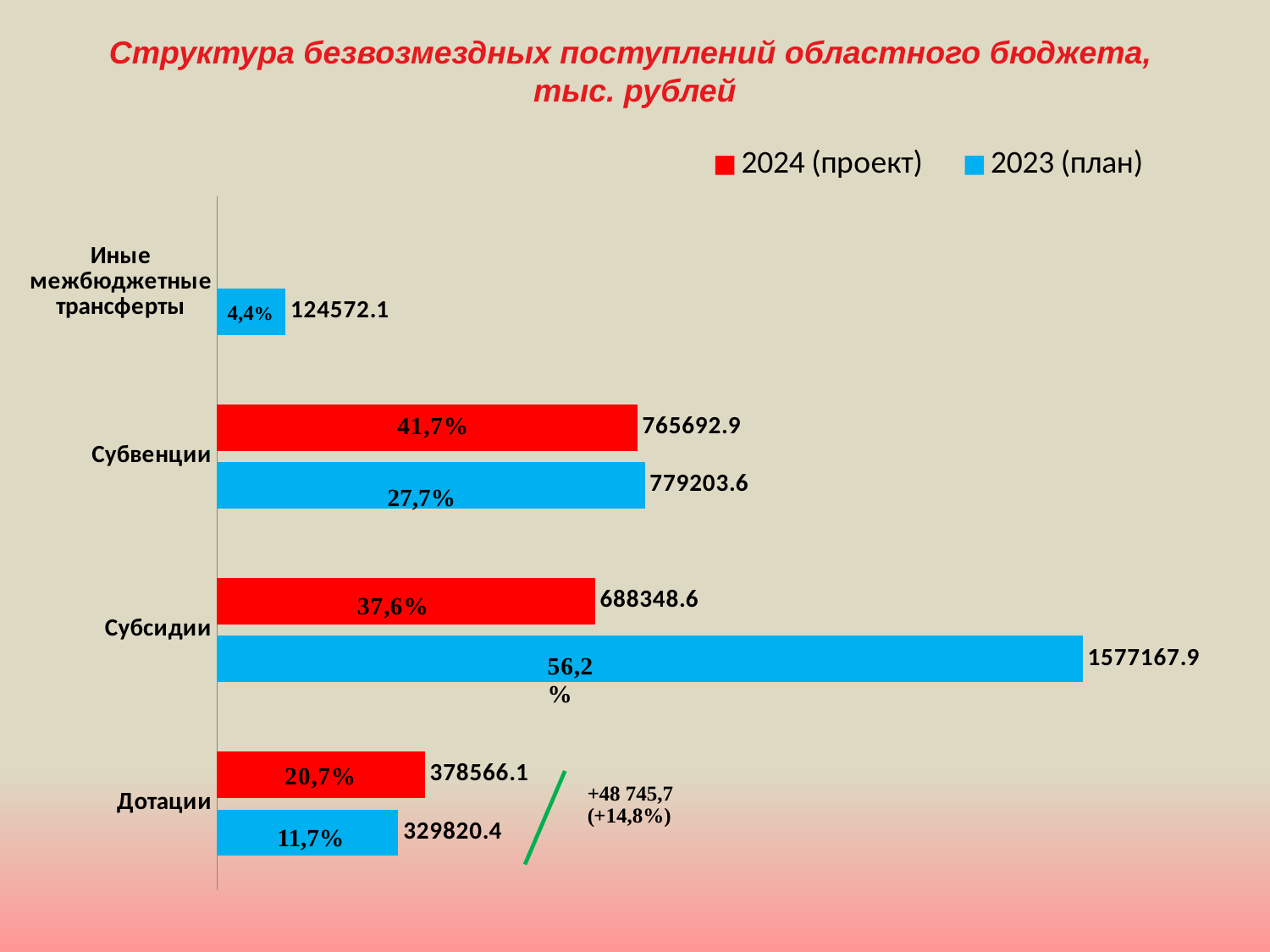
What is the 2023 (план) value for Субсидии? 1577167.9 What is the 2023 (план) value for Иные межбюджетные трансферты? 124572.1 What percentage share is shown on the 2024 (проект) bar for Дотации? 20,7% What is the 2024 (проект) value for Субвенции? 765692.9 What is the difference between the 2024 (проект) and 2023 (план) values for Дотации? 48745.7 Which category has the highest 2023 (план) value? Субсидии What kind of chart is shown on the slide? Bar chart How many categories are shown on the chart? 4 Which category has the highest 2024 (проект) value? Субвенции Which is larger for Субсидии: the 2024 (проект) value or the 2023 (план) value? 2023 (план) How many series does the legend list? 2 Which category has the lowest 2023 (план) value? Иные межбюджетные трансферты